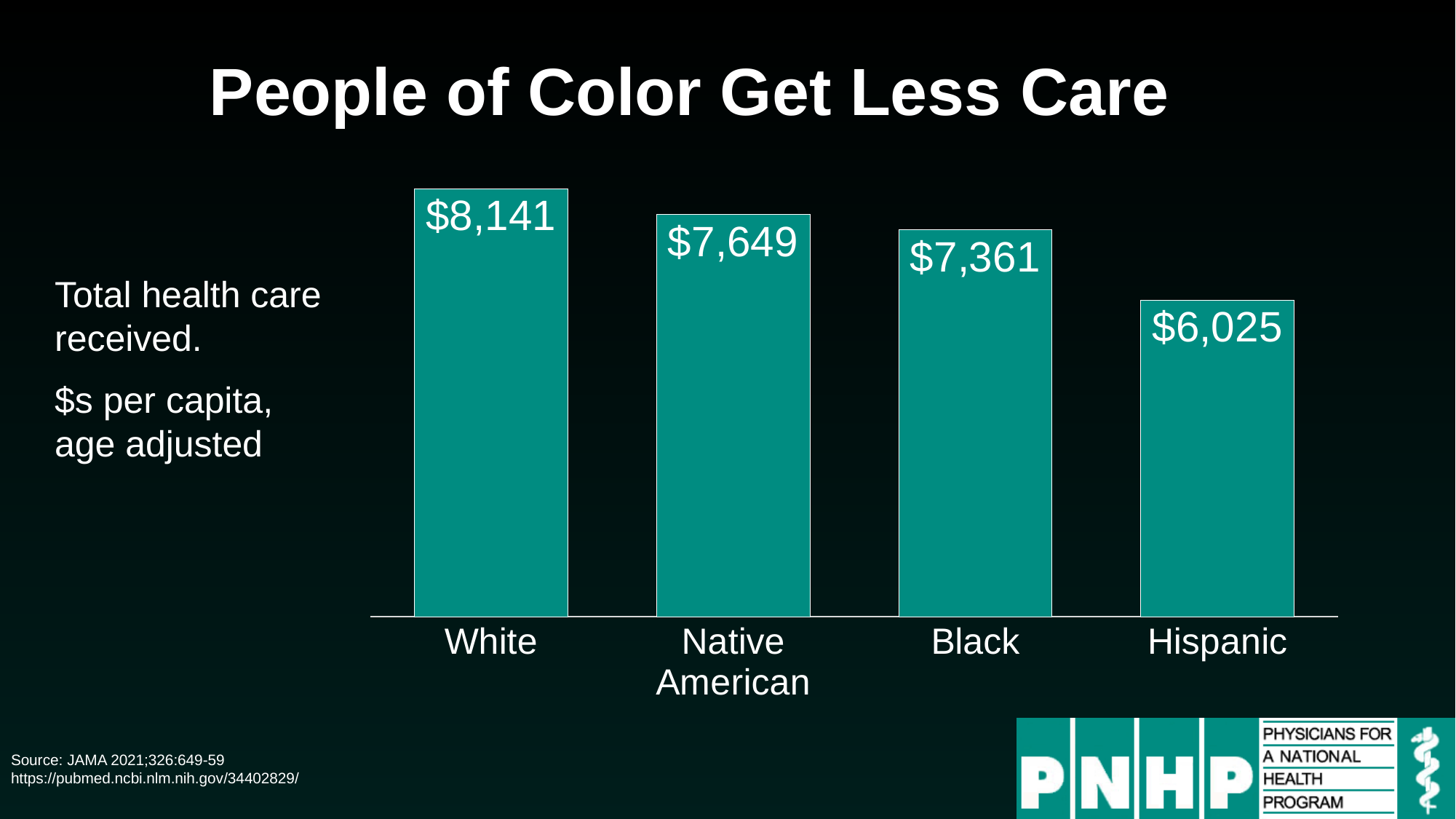
What is the difference between the values for White and Hispanic? $2,116 Which is larger, the value for Black or the value for Hispanic? Black What is the value for Hispanic? $6,025 What kind of chart is shown on the slide? Bar chart Which category has the highest value? White What is the difference between the values for Native American and Black? $288 What is the value for Black? $7,361 What is the value for Native American? $7,649 How many categories are shown in the chart? 4 What is the value for White? $8,141 Which category has the lowest value? Hispanic What is the title of the slide? People of Color Get Less Care